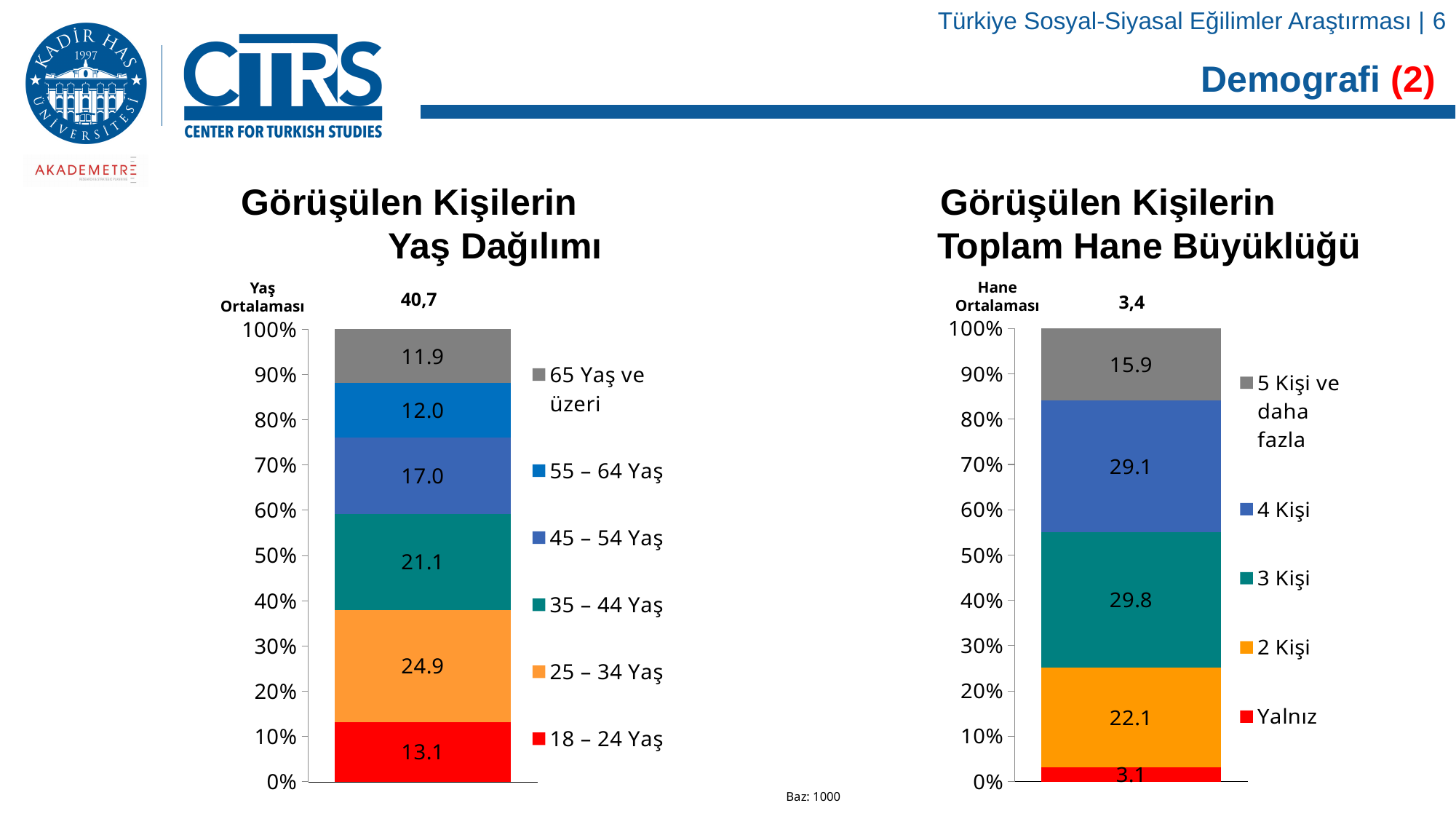
In the 'Görüşülen Kişilerin Yaş Dağılımı' chart, which age group has the smallest share? 65 Yaş ve üzeri In the 'Görüşülen Kişilerin Toplam Hane Büyüklüğü' chart, what is the difference between the 4 Kişi and 5 Kişi ve daha fazla values? 13.2 In the 'Görüşülen Kişilerin Yaş Dağılımı' chart, what is the difference between the 35 – 44 Yaş and 18 – 24 Yaş values? 8.0 In the 'Görüşülen Kişilerin Yaş Dağılımı' chart, what is the value for the 25 – 34 Yaş segment? 24.9 In the 'Görüşülen Kişilerin Toplam Hane Büyüklüğü' chart, which is larger: the value for 3 Kişi or 4 Kişi? 3 Kişi In the 'Görüşülen Kişilerin Yaş Dağılımı' chart, which age group has the largest share? 25 – 34 Yaş In the 'Görüşülen Kişilerin Toplam Hane Büyüklüğü' chart, what is the value for the 2 Kişi segment? 22.1 What kind of chart is the 'Görüşülen Kişilerin Toplam Hane Büyüklüğü' chart? Stacked bar chart In the 'Görüşülen Kişilerin Toplam Hane Büyüklüğü' chart, which household size has the largest share? 3 Kişi In the 'Görüşülen Kişilerin Toplam Hane Büyüklüğü' chart, which household size has the smallest share? Yalnız In the 'Görüşülen Kişilerin Yaş Dağılımı' chart, how many age groups does the legend list? 6 In the 'Görüşülen Kişilerin Yaş Dağılımı' chart, what is the average age (Yaş Ortalaması) shown above the bar? 40,7